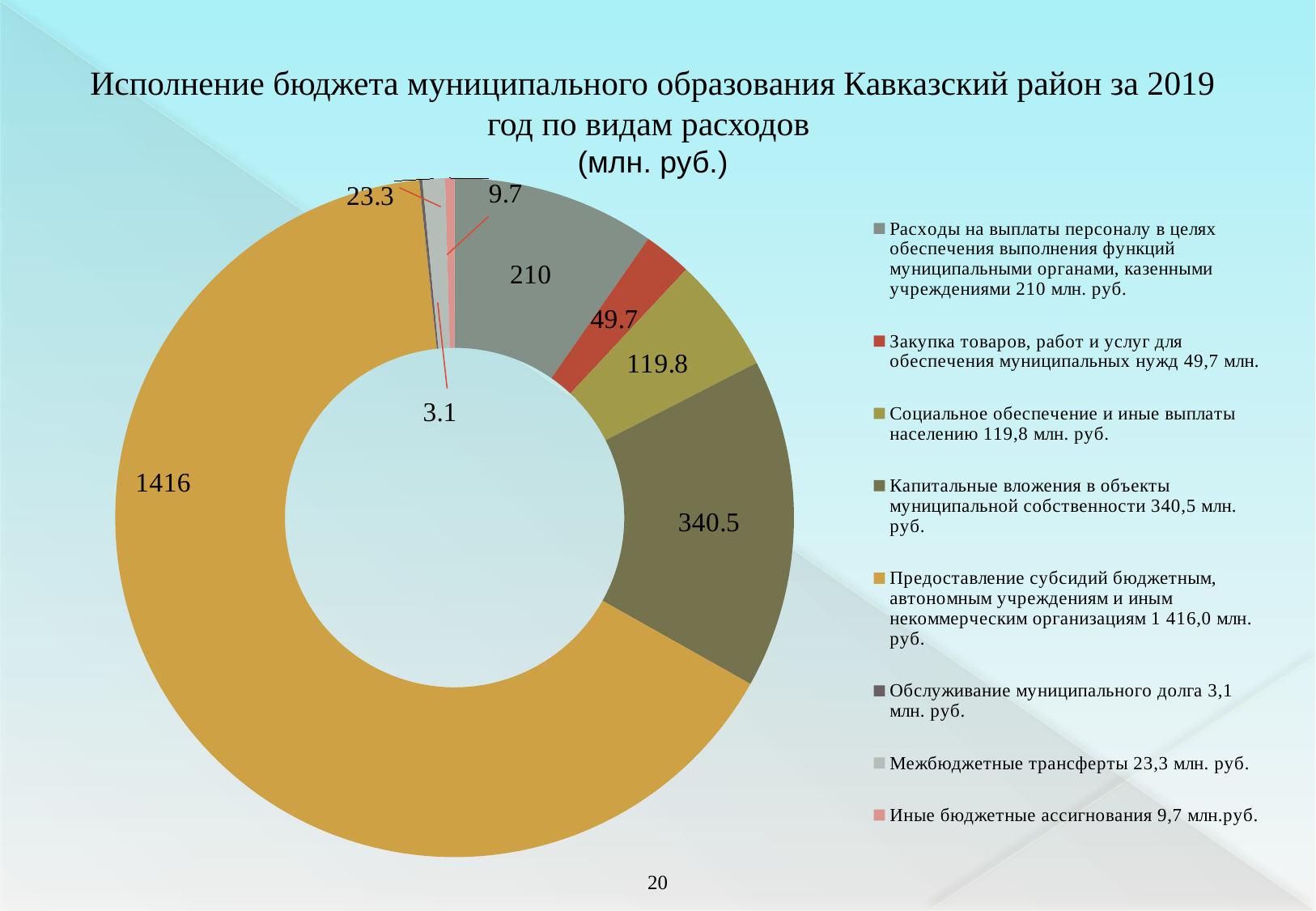
Which is larger: Социальное обеспечение и иные выплаты населению or Закупка товаров, работ и услуг? Социальное обеспечение и иные выплаты населению What is the value for Капитальные вложения в объекты муниципальной собственности? 340.5 Which category has the largest value? Предоставление субсидий бюджетным, автономным учреждениям и иным некоммерческим организациям What kind of chart is shown on the slide? doughnut chart Which category has the smallest value? Обслуживание муниципального долга What is the value for Обслуживание муниципального долга? 3.1 What is the difference between the values for Межбюджетные трансферты and Иные бюджетные ассигнования? 13.6 What is the value for Закупка товаров, работ и услуг для обеспечения муниципальных нужд? 49.7 What is the value for Предоставление субсидий бюджетным, автономным учреждениям и иным некоммерческим организациям? 1416 What unit is stated in the chart title? млн. руб. How many categories does the chart show? 8 What is the difference between the values for Капитальные вложения в объекты муниципальной собственности and Расходы на выплаты персоналу? 130.5